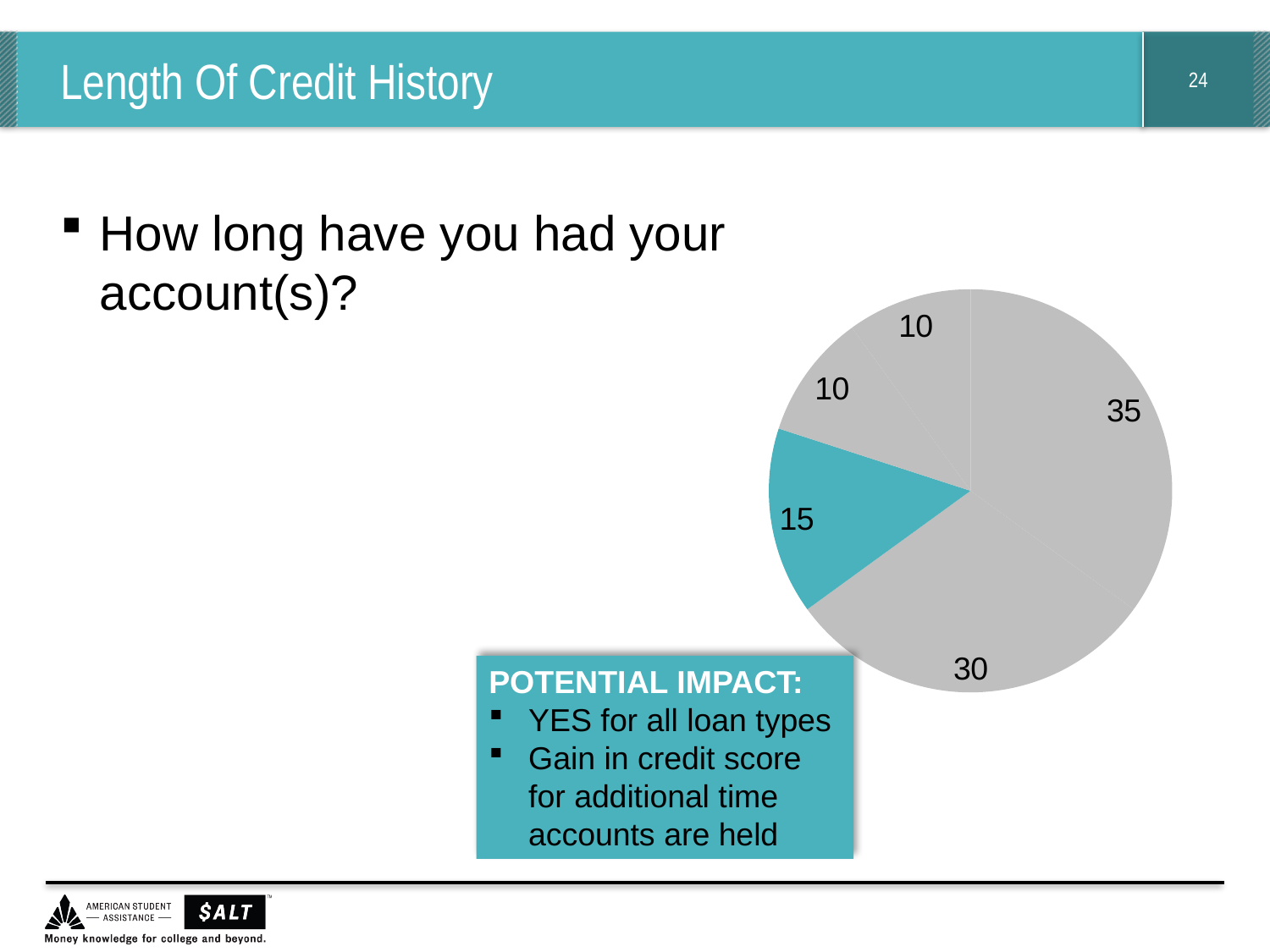
What share of the pie does the largest slice represent? 35% What is the value of the smallest slice in the pie chart? 10 How many slices in the pie chart are labeled 10? 2 What is the total of all the slice values in the pie chart? 100 How many slices does the pie chart have? 5 What is the difference between the largest slice and the teal slice? 20 What share of the pie does the teal slice represent? 15% What kind of chart is shown on the slide? pie chart What is the value of the teal (highlighted) slice in the pie chart? 15 What is the value of the largest slice in the pie chart? 35 What is the difference between the two largest slices (35 and 30)? 5 Is the teal slice larger or smaller than the slice labeled 30? smaller